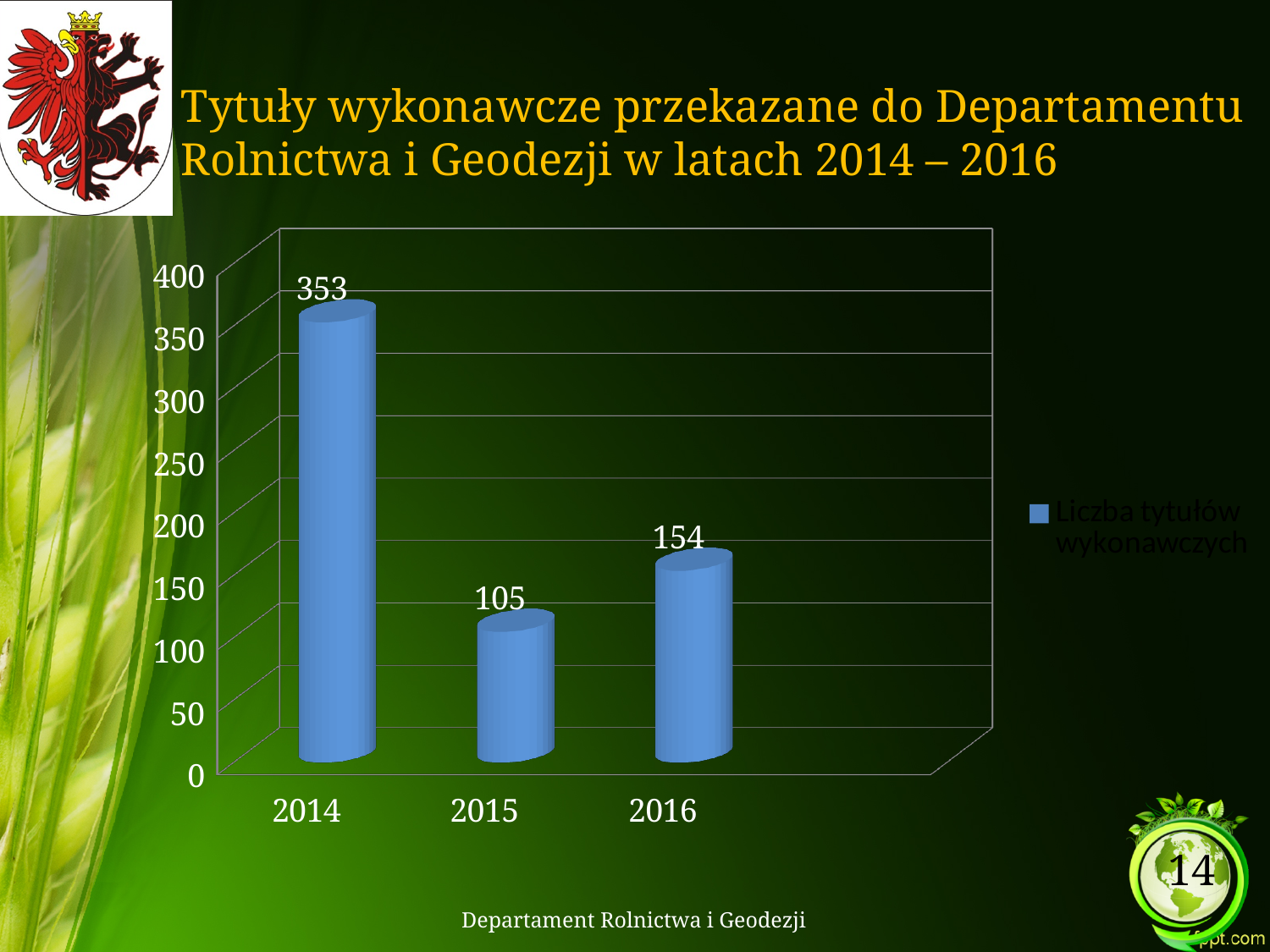
What kind of chart is shown? bar chart What is the legend entry for the series? Liczba tytułów wykonawczych What is the value for 2014? 353 What is the difference between the values for 2014 and 2015? 248 What is the value for 2015? 105 What is the value for 2016? 154 Which year has the highest value? 2014 How many years are shown on the x axis? 3 Which is larger, the value for 2015 or the value for 2016? 2016 What is the difference between the values for 2016 and 2015? 49 Which year has the lowest value? 2015 How many series does the legend list? 1